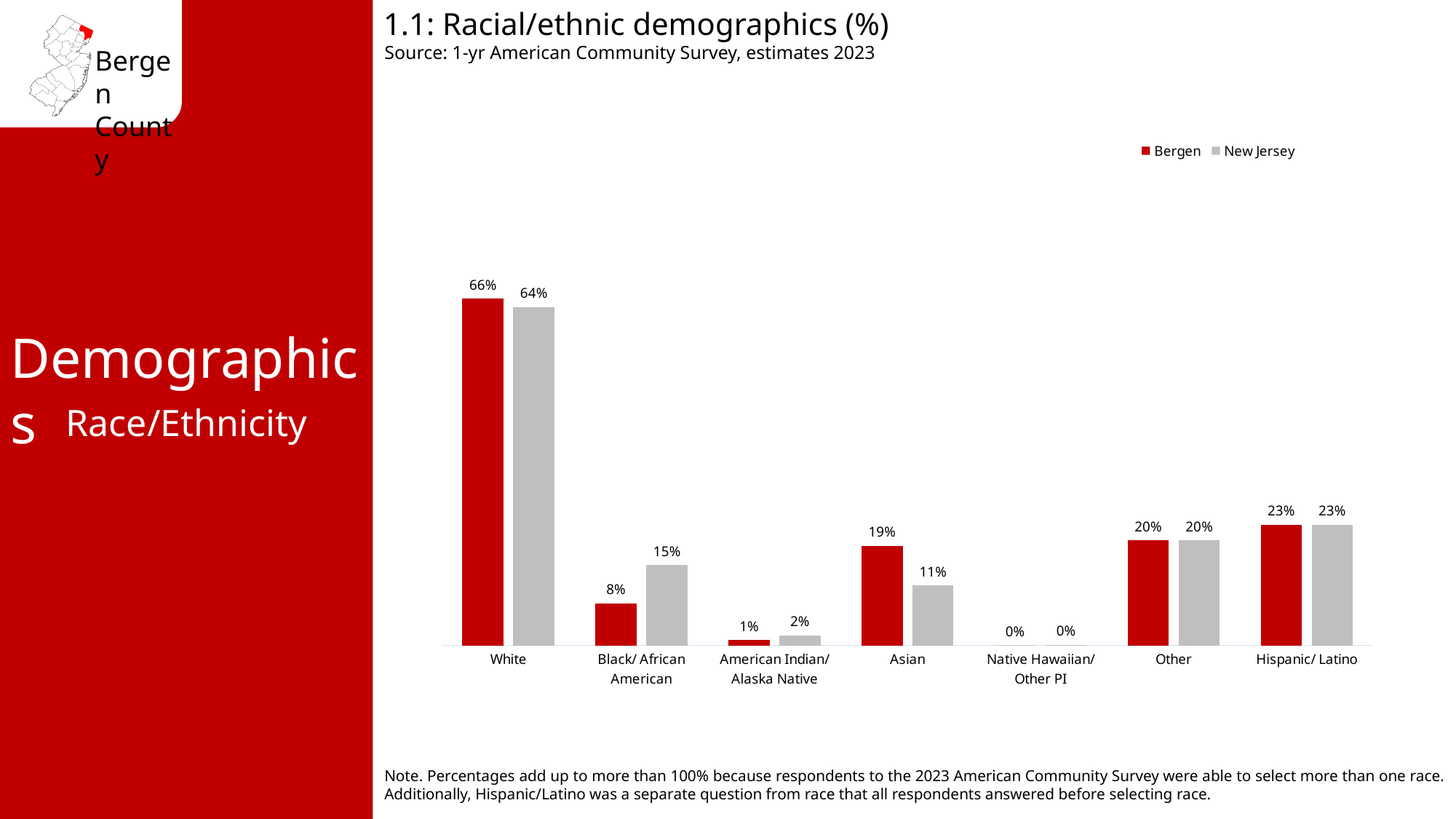
Which is larger for Black/ African American, the Bergen value or the New Jersey value? New Jersey How many series does the legend list? 2 What is the New Jersey value for Black/ African American? 15% What is the Bergen value for Asian? 19% What is the Bergen value for White? 66% Which category has the lowest New Jersey value? Native Hawaiian/ Other PI What is the difference between the Bergen and New Jersey values for Asian? 8% What kind of chart is shown on the slide? Bar chart What is the difference between the New Jersey and Bergen values for Black/ African American? 7% Which category has the highest Bergen value? White How many categories are shown on the x axis? 7 What is the New Jersey value for Hispanic/ Latino? 23%